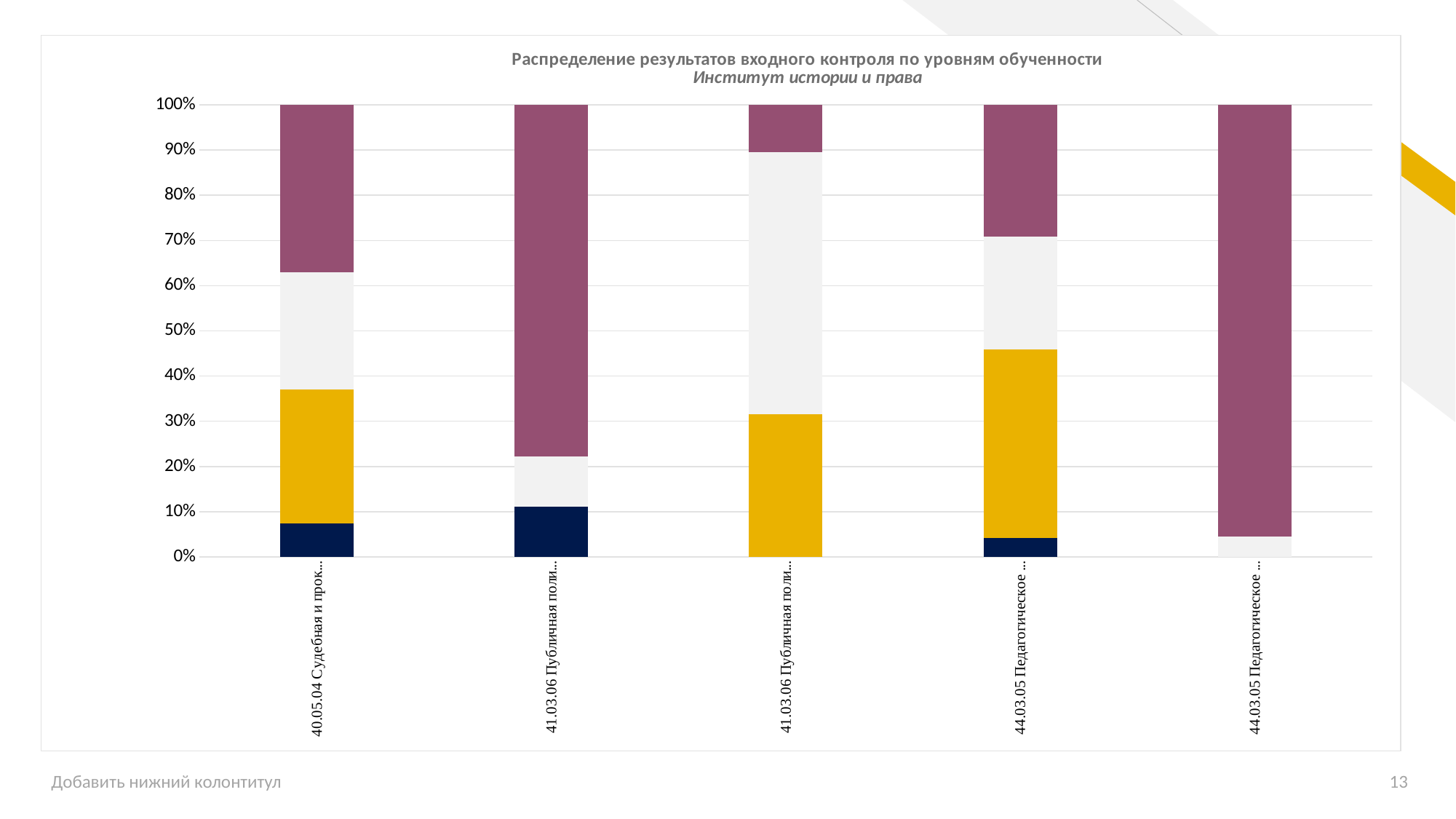
In the fourth bar (44.03.05 Педагогическое ...), is the top of the yellow segment greater or less than 40%? greater Which bar has the largest light grey segment? The third bar (41.03.06 Публичная поли...) In the first bar (40.05.04 Судебная и прок...), is the top of the yellow segment greater or less than 30%? greater How many bars (categories) are plotted in the chart? 5 In the second bar (41.03.06 Публичная поли...), is the top of the dark navy segment greater or less than 20%? less Is the purple segment larger in the second bar or in the third bar? The second bar Which bar has the largest purple segment? The fifth bar (44.03.05 Педагогическое ...) What is the total height of each stacked bar on the vertical axis? 100% What kind of chart is shown on the slide? Stacked bar chart Which institute is named in the chart's subtitle? Институт истории и права What is the title of the chart? Распределение результатов входного контроля по уровням обученности